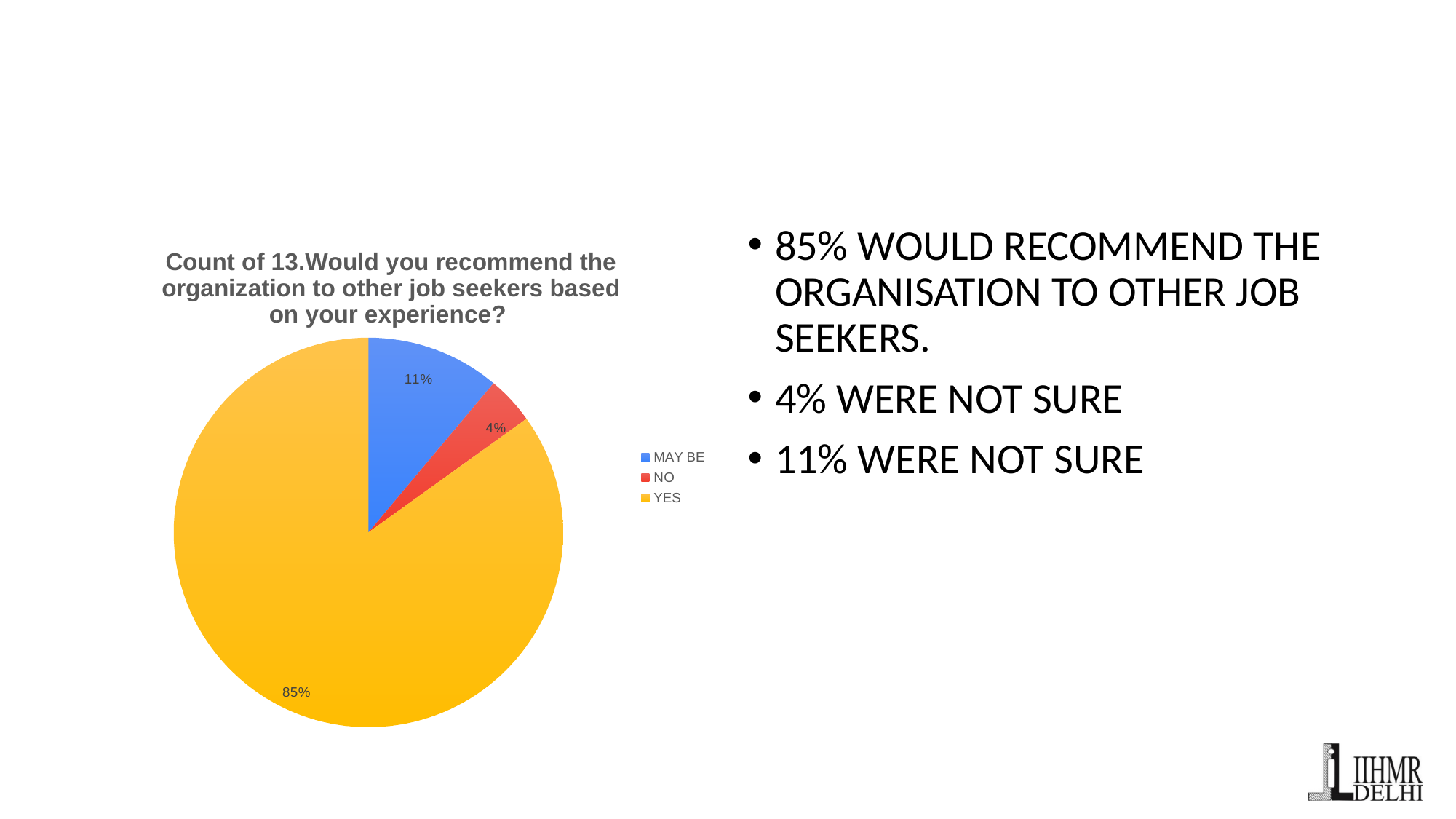
How many entries does the legend list? 3 Which category has the smallest slice of the pie? NO Which slice is larger, MAY BE or NO? MAY BE What is the difference in percentage points between the YES and MAY BE slices? 74 What share of the pie does YES represent? 85% How many categories does the pie chart show? 3 What is the difference in percentage points between the MAY BE and NO slices? 7 Which category has the largest slice of the pie? YES What kind of chart is shown on the slide? Pie chart What share of the pie does NO represent? 4% What colour is the YES slice in the pie chart? Yellow What share of the pie does MAY BE represent? 11%